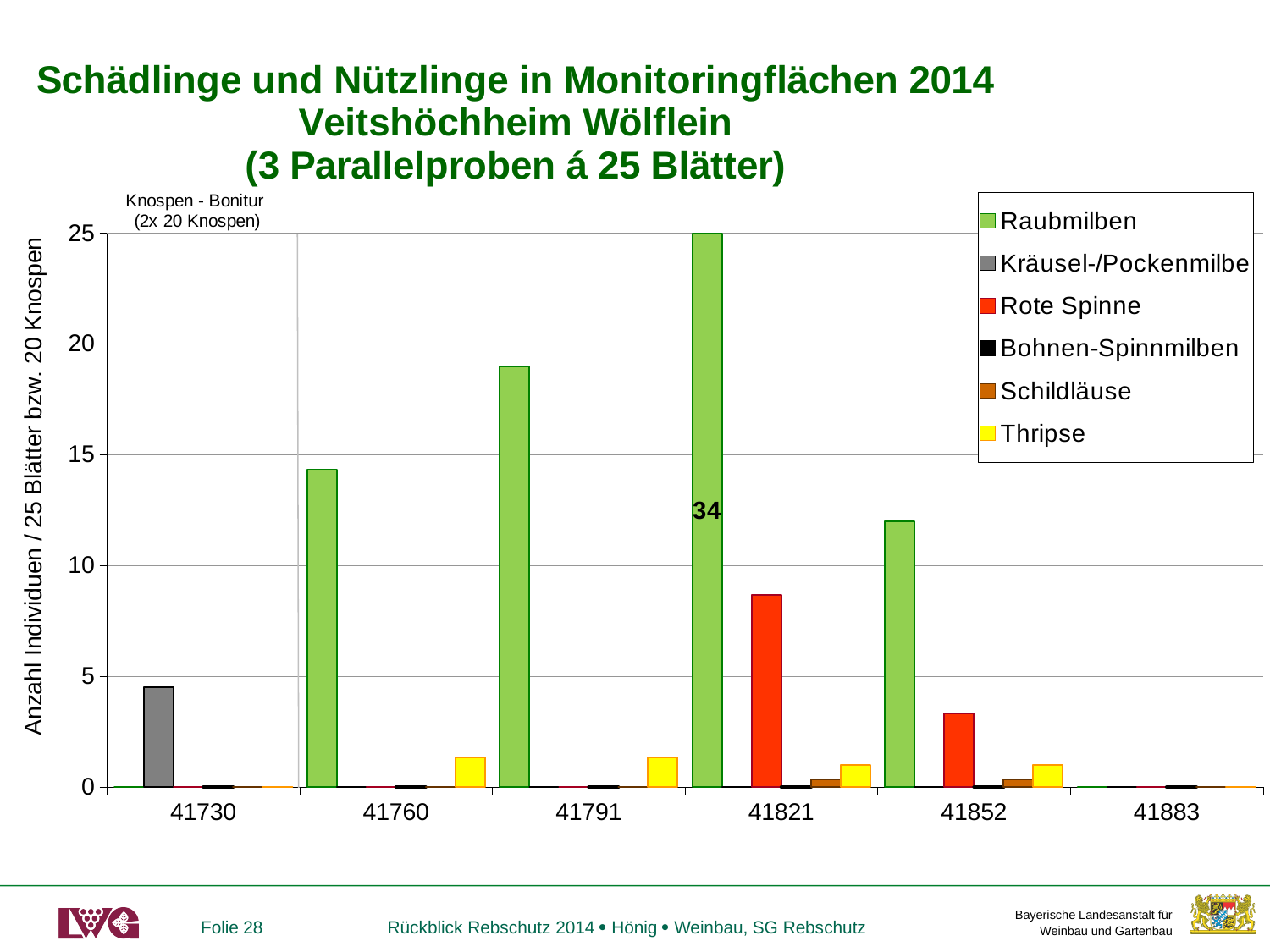
How many series does the legend list? 6 Is the Rote Spinne value for 41821 greater or less than 5? greater What is the value of Raubmilben for category 41821? 34 Which category has the larger Rote Spinne value, 41821 or 41852? 41821 Is the Kräusel-/Pockenmilbe value for 41730 greater or less than 5? less How many categories are shown on the x axis? 6 Which series is listed first in the legend? Raubmilben For which category is the Raubmilben value highest? 41821 What kind of chart is shown on the slide? bar chart Which category has the larger Raubmilben value, 41760 or 41791? 41791 Is the Raubmilben value for 41791 greater or less than 15? greater